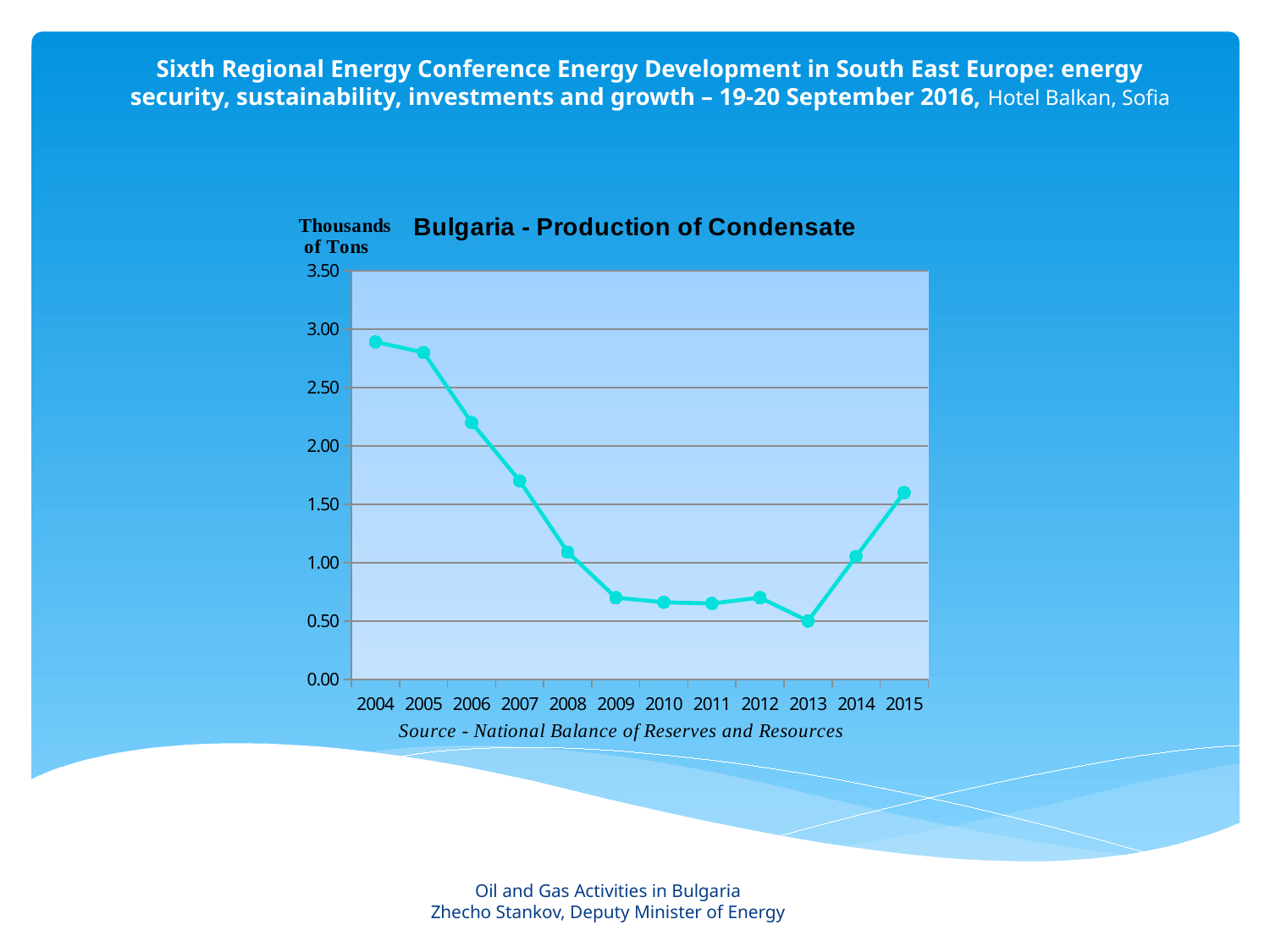
How many years are plotted on the x axis of the chart? 12 Which year has the lowest production of condensate? 2013 Which year has the larger value, 2006 or 2007? 2006 What kind of chart is shown on the slide? line chart Is the value for 2005 greater or less than 2.50? greater Is the value for 2009 greater or less than 1.00? less Which year has the larger value, 2014 or 2015? 2015 Do the values rise or fall from 2004 to 2009? fall Is the value for 2007 greater or less than 2.00? less What unit is given for the y axis of the chart? Thousands of Tons